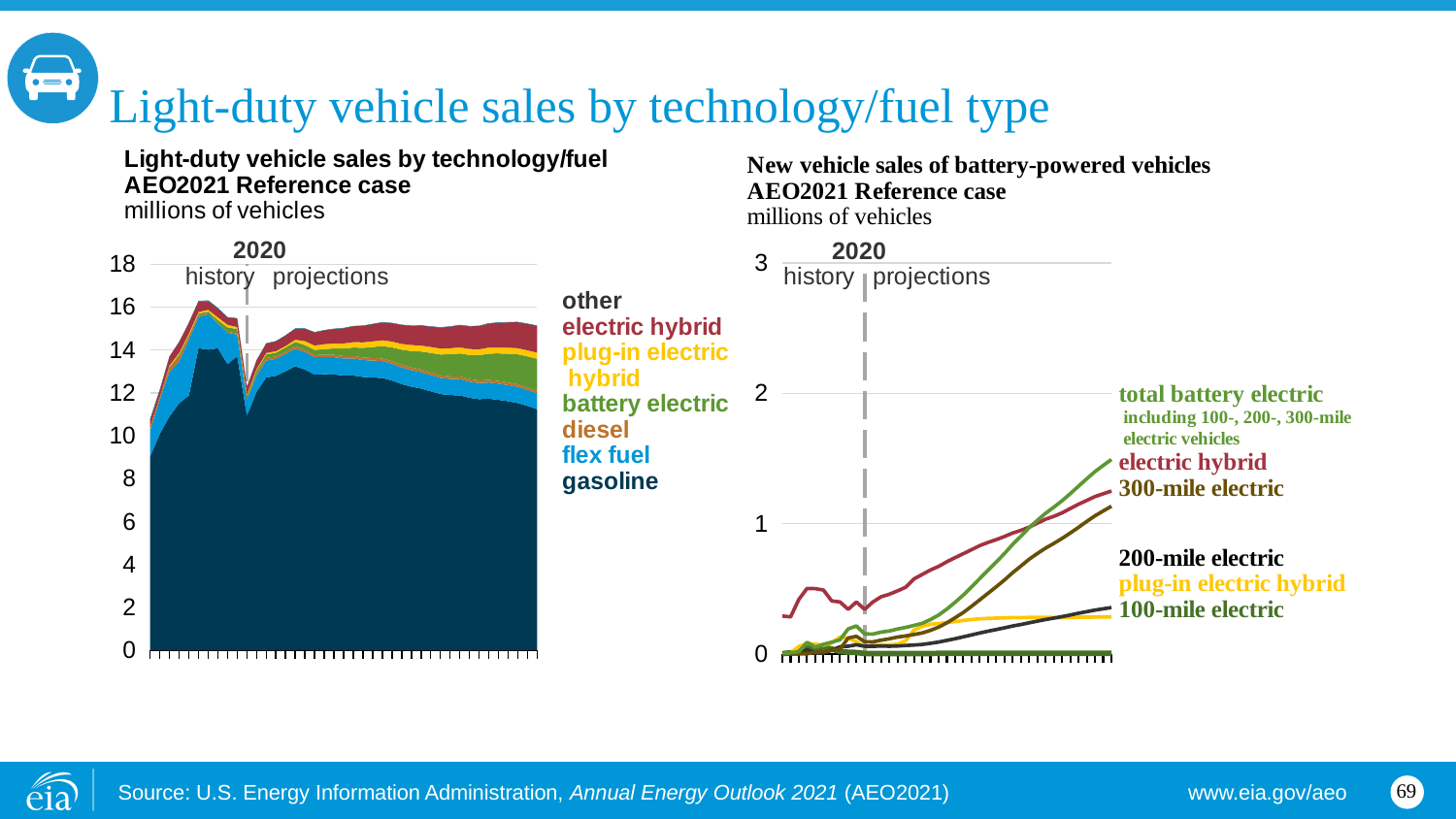
In the right-hand chart, 'New vehicle sales of battery-powered vehicles', which line is highest at the end of the projection period? total battery electric What kind of chart is the right-hand chart, 'New vehicle sales of battery-powered vehicles'? line chart In the right-hand chart, 'New vehicle sales of battery-powered vehicles', does the total battery electric line rise or fall over the projection period? rise What unit of measurement is used on both charts on the slide? millions of vehicles In the right-hand chart, 'New vehicle sales of battery-powered vehicles', is the value for total battery electric at the end of the projections greater or less than 1? greater How many series does the legend of the left-hand chart, 'Light-duty vehicle sales by technology/fuel', list? 7 In the left-hand chart, 'Light-duty vehicle sales by technology/fuel', is the gasoline value at the end of the projections greater or less than 10? greater In the right-hand chart, 'New vehicle sales of battery-powered vehicles', is the value for total battery electric at the end of the projections greater or less than 2? less What kind of chart is the left-hand chart, 'Light-duty vehicle sales by technology/fuel'? stacked area chart How many labeled lines are shown on the right-hand chart, 'New vehicle sales of battery-powered vehicles'? 6